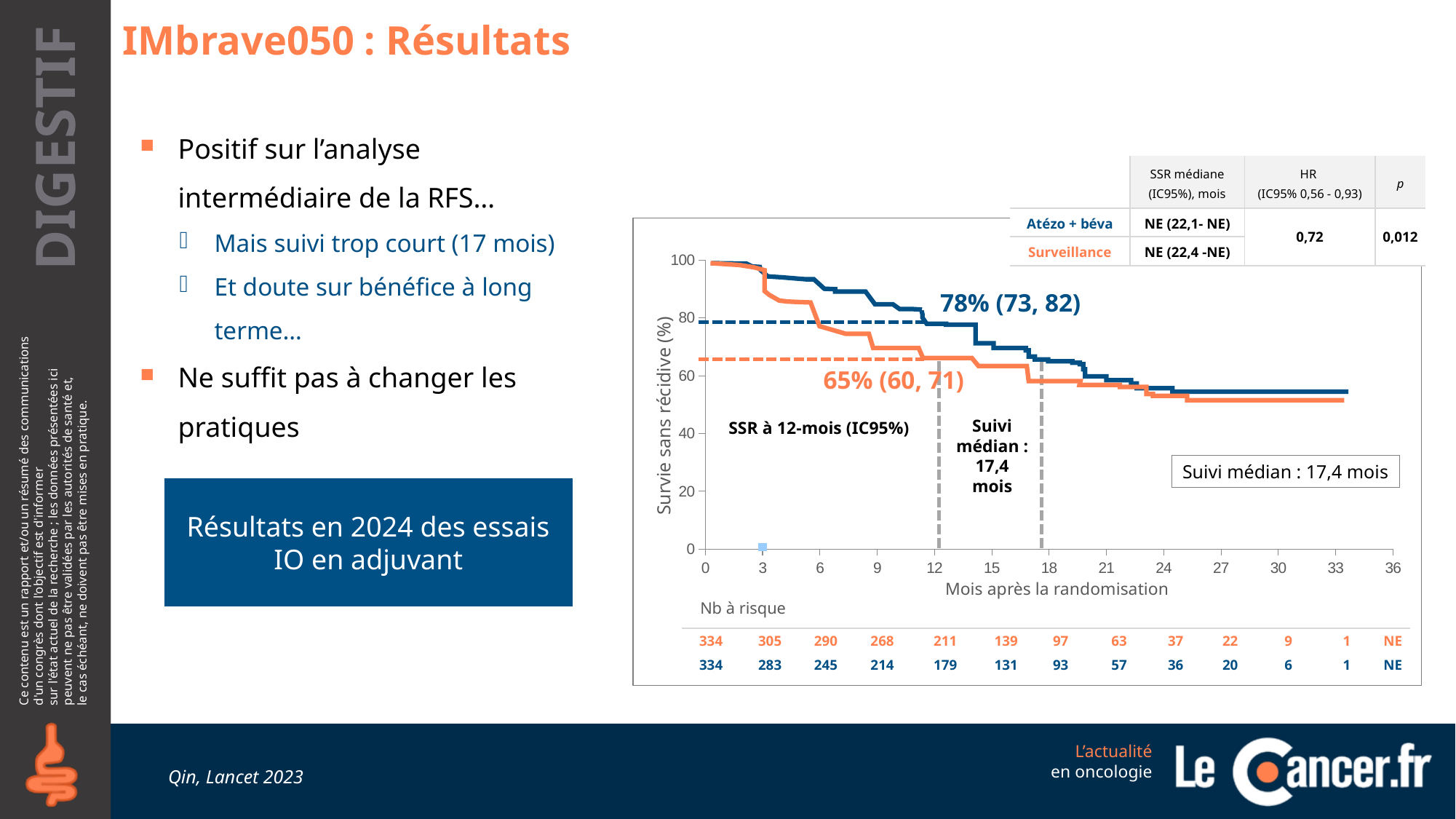
What is the p-value shown in the table? 0,012 What is the 12-month recurrence-free survival (SSR à 12 mois) for the Atézo + béva arm? 78% (73, 82) What kind of chart is shown on the slide? line chart What is the label of the y axis of the chart? Survie sans récidive (%) Do the survival curves rise or fall along the x axis (months after randomisation)? fall What is the difference in 12-month recurrence-free survival between the Atézo + béva arm and the Surveillance arm? 13% What is the 12-month recurrence-free survival (SSR à 12 mois) for the Surveillance arm? 65% (60, 71) How many patients were at risk in the Surveillance arm at 12 months? 211 Which arm has the higher 12-month recurrence-free survival, Atézo + béva or Surveillance? Atézo + béva How many patients were at risk in the Atézo + béva arm at 15 months? 131 What is the median follow-up (suivi médian) indicated on the chart? 17,4 mois What is the hazard ratio (HR) shown in the table? 0,72